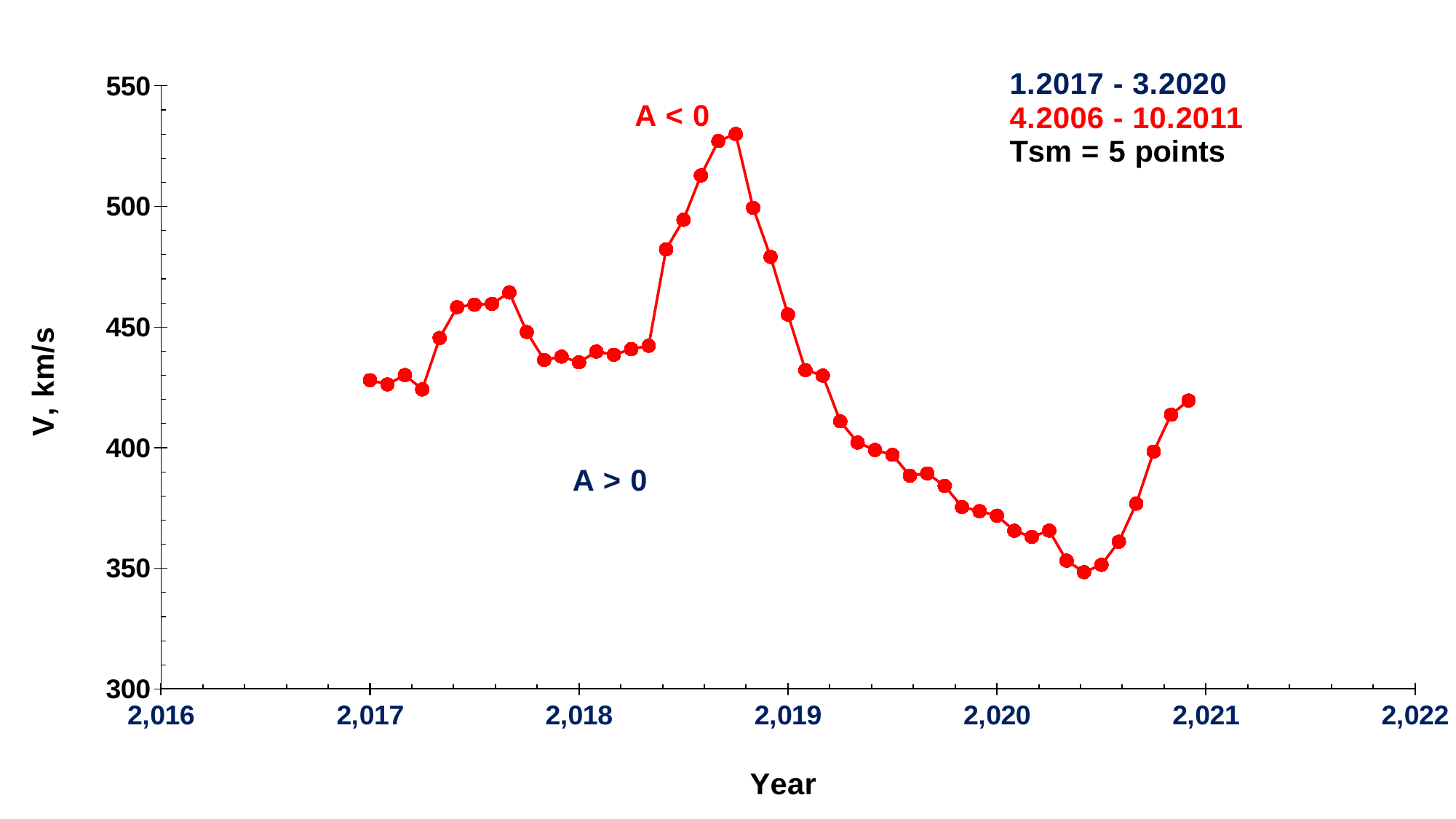
What is the highest value shown on the y axis? 550 Is the lowest value on the line greater or less than 400? less Do the values rise or fall between the years 2019 and 2020? fall What is the label of the x axis? Year Is the value at the year 2018 greater or less than 450? less Is the value at the year 2020 greater or less than 400? less What is the label of the y axis? V, km/s What kind of chart is shown on the slide? line chart Which is larger, the value at the year 2018 or the value at the year 2020? 2018